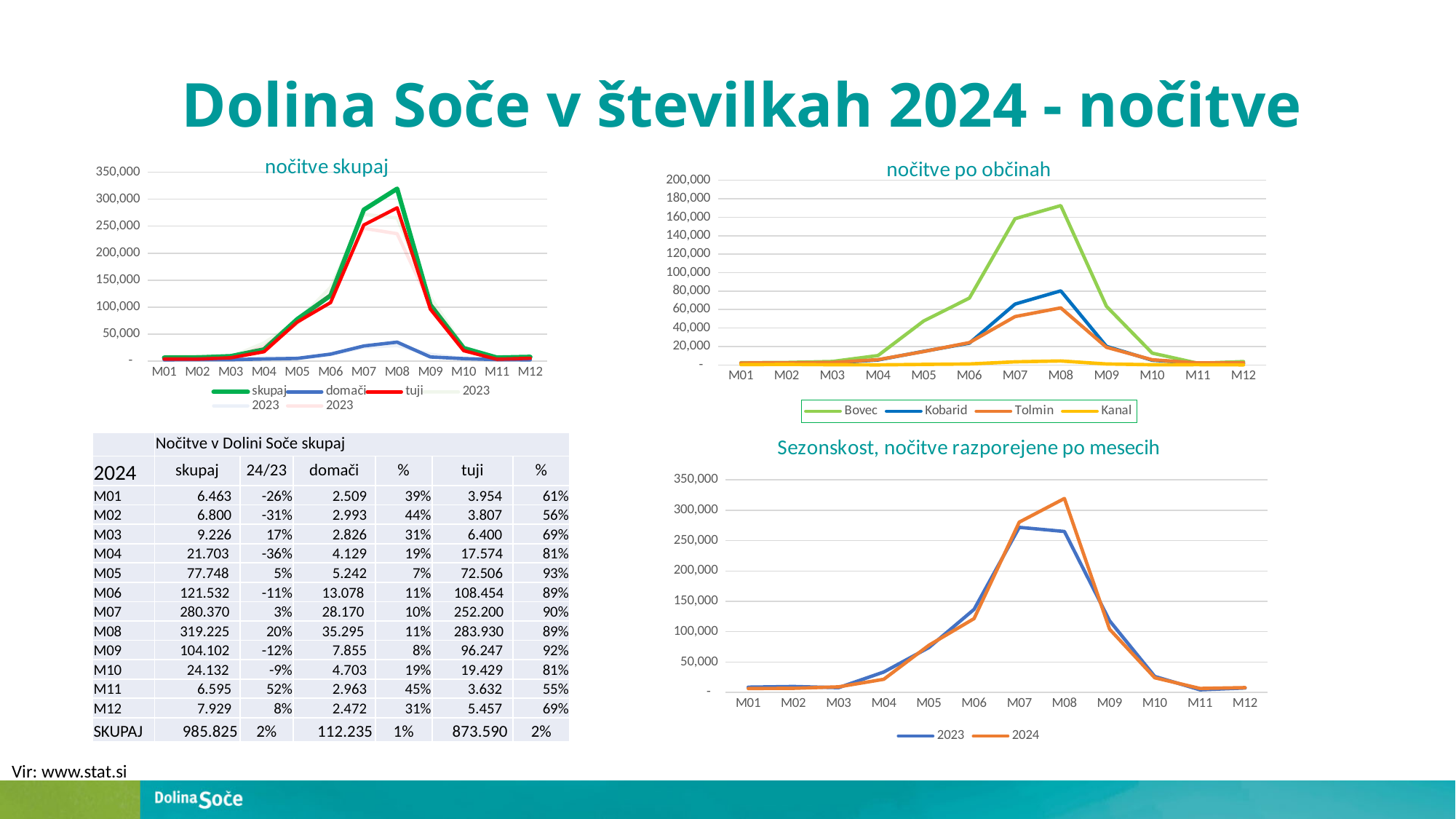
In the 'nočitve skupaj' chart, is the value for skupaj at M08 greater or less than 300,000? greater In the 'nočitve po občinah' chart, is the value for Bovec at M08 greater or less than 160,000? greater In the 'nočitve skupaj' chart, is the value for domači at M08 greater or less than 50,000? less How many series does the legend of the 'nočitve po občinah' chart list? 4 In the 'nočitve skupaj' chart, which month has the highest value for skupaj? M08 In the 'nočitve po občinah' chart, which municipality has the lowest values across the year? Kanal In the 'Sezonskost, nočitve razporejene po mesecih' chart, do the values for 2024 rise or fall from M08 to M11? fall How many months are shown on the x axis of the 'Sezonskost, nočitve razporejene po mesecih' chart? 12 What kind of chart is the 'nočitve skupaj' chart? line chart In the 'nočitve po občinah' chart, which is larger at M08, Bovec or Kobarid? Bovec In the 'nočitve po občinah' chart, which month has the highest value for Bovec? M08